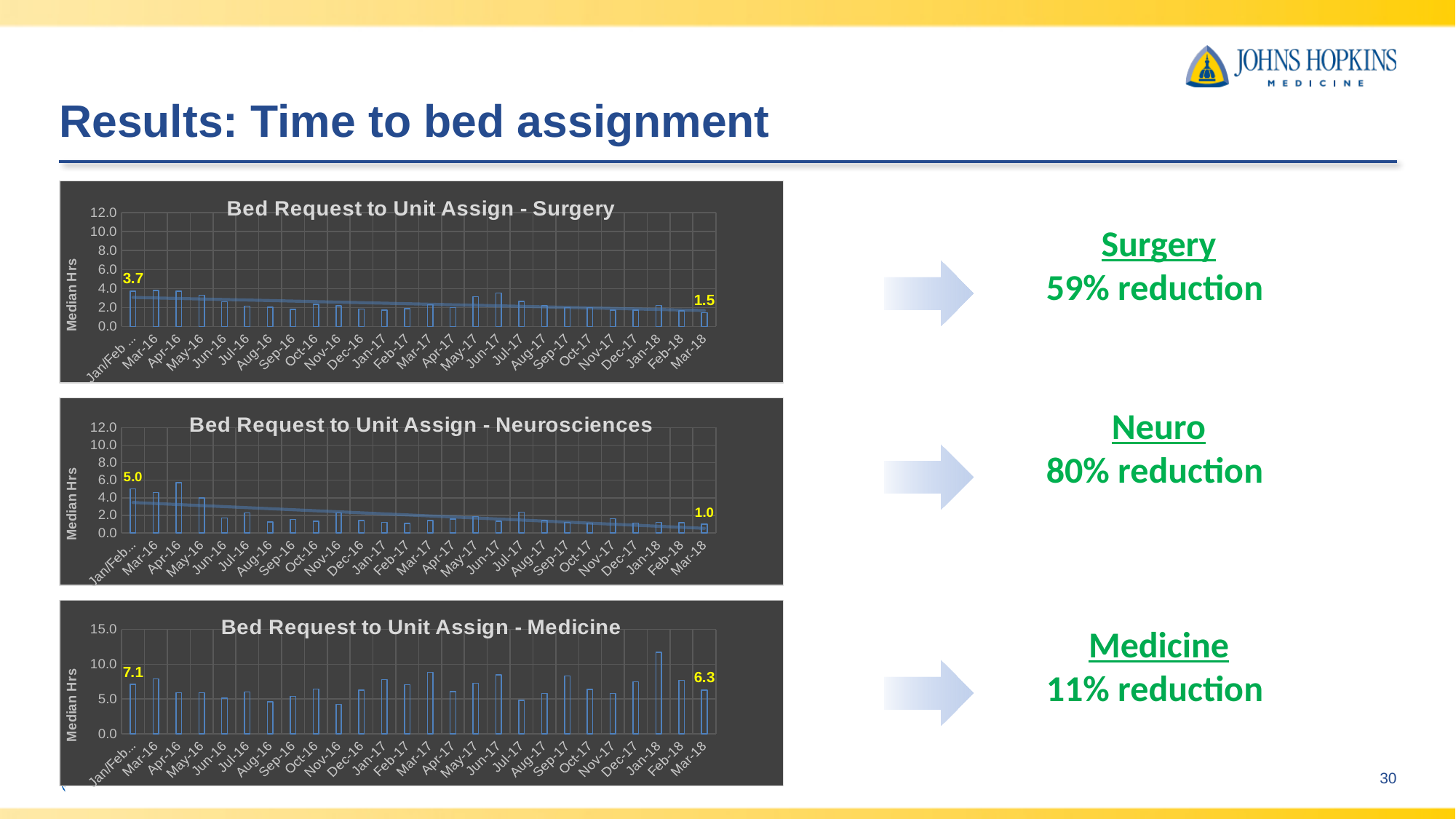
In the 'Bed Request to Unit Assign - Medicine' chart, what is the labelled value for Mar-18? 6.3 What kind of chart is 'Bed Request to Unit Assign - Medicine'? bar chart In the 'Bed Request to Unit Assign - Surgery' chart, do the values generally rise or fall from left to right along the x axis? fall In the 'Bed Request to Unit Assign - Surgery' chart, what is the labelled value for Mar-18? 1.5 In the 'Bed Request to Unit Assign - Medicine' chart, which month has the highest bar? Jan-18 In the 'Bed Request to Unit Assign - Surgery' chart, what is the labelled value for the first bar (Jan/Feb)? 3.7 In the 'Bed Request to Unit Assign - Neurosciences' chart, by how much does the labelled value fall from the first bar to Mar-18? 4.0 In the 'Bed Request to Unit Assign - Medicine' chart, is the value for Jan-18 greater or less than 10.0? greater In the 'Bed Request to Unit Assign - Neurosciences' chart, is the value for Apr-16 greater or less than 4.0? greater In the 'Bed Request to Unit Assign - Medicine' chart, what is the difference between the first labelled value (7.1) and the Mar-18 value? 0.8 In the 'Bed Request to Unit Assign - Neurosciences' chart, what is the labelled value for Mar-18? 1.0 In the 'Bed Request to Unit Assign - Neurosciences' chart, what is the labelled value for the first bar (Jan/Feb)? 5.0